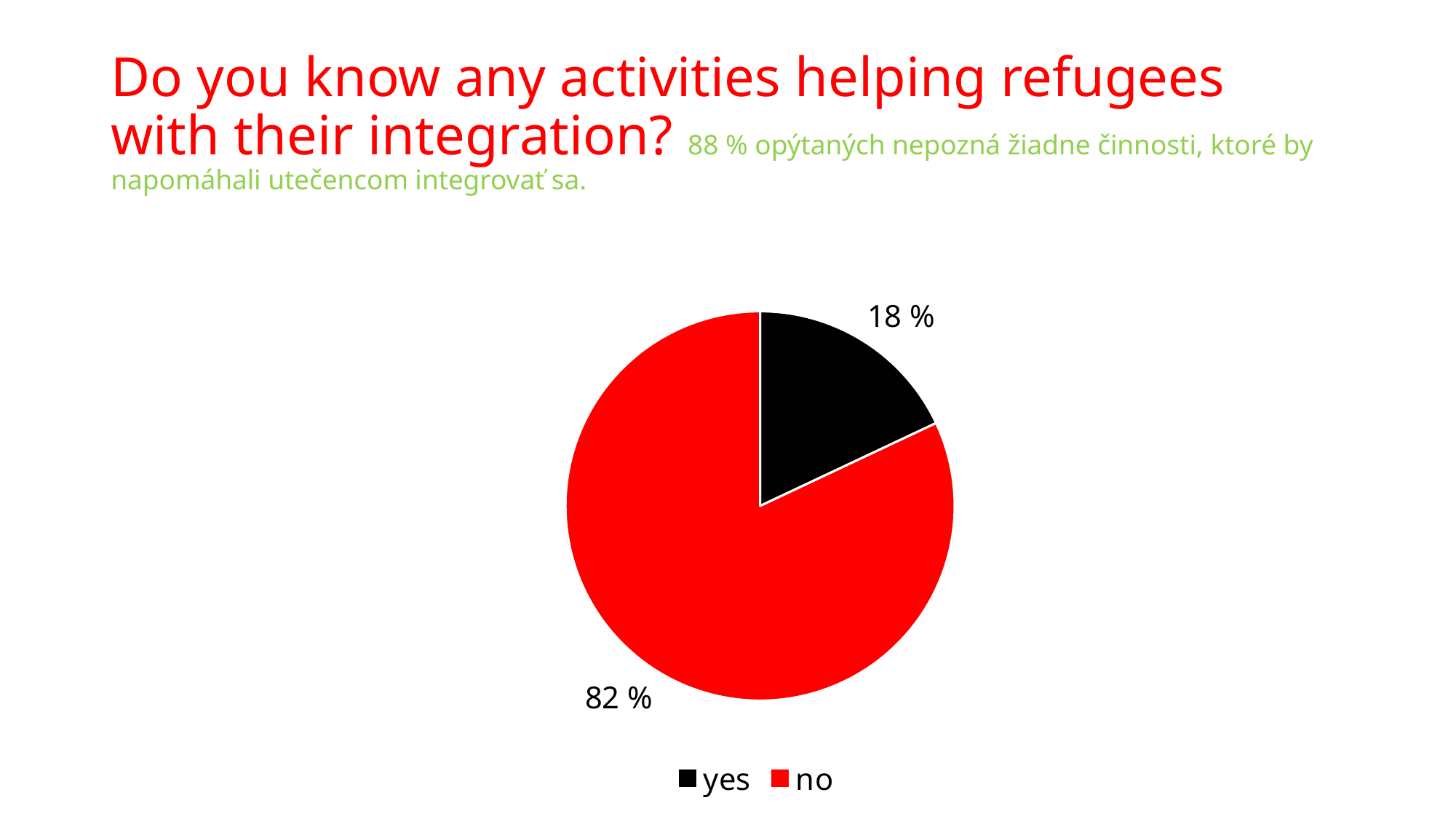
How many entries does the legend list? 2 Which answer has the smallest share of the pie? yes What kind of chart is shown on the slide? pie chart Which answer has the largest share of the pie? no What is the difference in percentage points between the "no" and "yes" slices? 64 How many slices does the pie chart have? 2 What colour is the "no" slice? red What colour is the "yes" slice? black What percentage of respondents answered "no"? 82 % What percentage of respondents answered "yes"? 18 % What share of the pie does the "yes" slice represent? 18 % Which slice is larger, "yes" or "no"? no